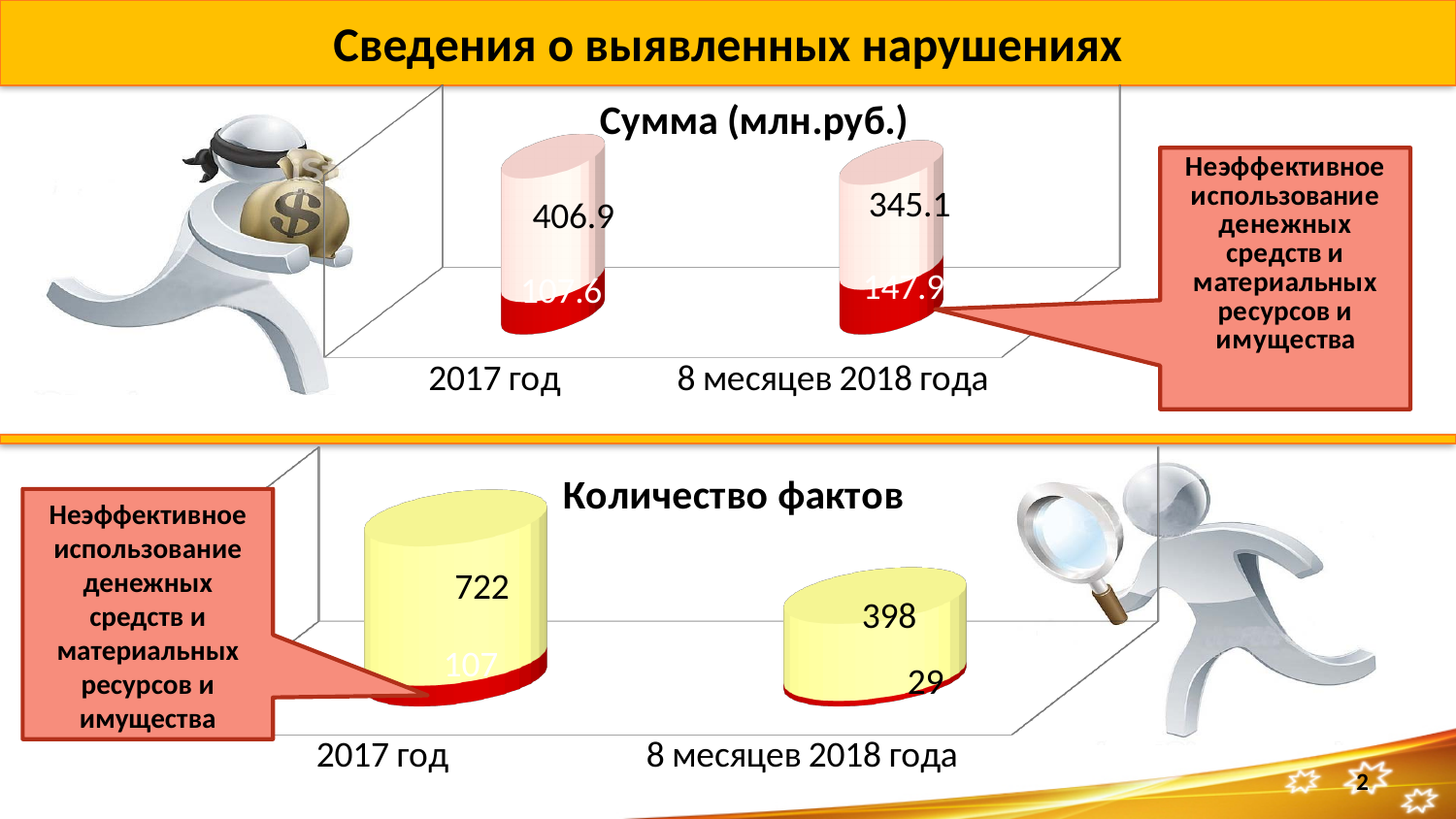
What kind of chart is the 'Сумма (млн.руб.)' chart at the top of the slide? bar chart In the 'Сумма (млн.руб.)' chart, what is the difference between the upper-segment values for '2017 год' (406.9) and '8 месяцев 2018 года' (345.1)? 61.8 In the 'Количество фактов' chart, what value is printed on the upper (yellow) segment of the '8 месяцев 2018 года' bar? 398 In the 'Сумма (млн.руб.)' chart, which category has the larger upper-segment value: '2017 год' or '8 месяцев 2018 года'? 2017 год In the 'Сумма (млн.руб.)' chart, what value is printed on the upper (pink) segment of the '8 месяцев 2018 года' bar? 345.1 In the 'Сумма (млн.руб.)' chart, what value is printed on the upper (pink) segment of the '2017 год' bar? 406.9 In the 'Количество фактов' chart, what value is printed on the red segment of the '8 месяцев 2018 года' bar? 29 What is the title of the chart at the top of the slide? Сумма (млн.руб.) In the 'Количество фактов' chart, which category has the taller bar: '2017 год' or '8 месяцев 2018 года'? 2017 год In the 'Количество фактов' chart, what value is printed on the upper (yellow) segment of the '2017 год' bar? 722 In the 'Количество фактов' chart, what is the difference between the upper-segment values for '2017 год' (722) and '8 месяцев 2018 года' (398)? 324 How many categories are shown on the x axis of the 'Количество фактов' chart? 2